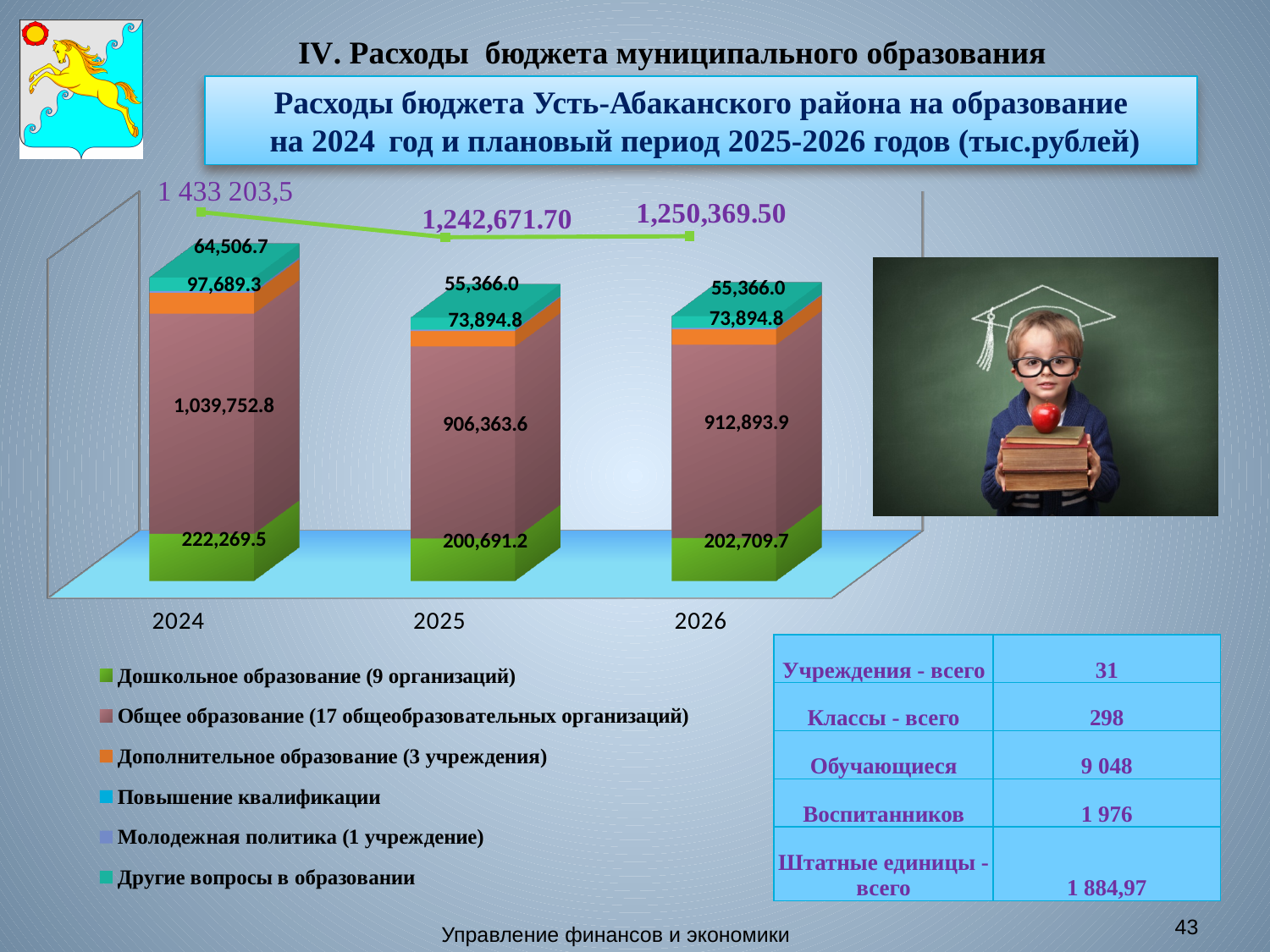
What is the value of the bottom green segment (Дошкольное образование) in the 2025 bar? 200,691.2 How many years (categories) are shown on the x axis of the chart? 3 What is the difference between the Общее образование values for 2026 and 2025? 6,530.3 What kind of chart is shown on the slide? Stacked bar chart How many series does the chart legend list? 6 What is the value of the largest segment (Общее образование) in the 2024 bar? 1,039,752.8 What total value is shown on the line above the 2025 bar? 1,242,671.70 Which legend entry is shown with the green colour? Дошкольное образование (9 организаций) Which year has the larger Дошкольное образование value, 2025 or 2026? 2026 In which year is the Общее образование segment the highest? 2024 In which year is the Дошкольное образование segment the lowest? 2025 Does the total shown on the line rise or fall from 2024 to 2025? Fall